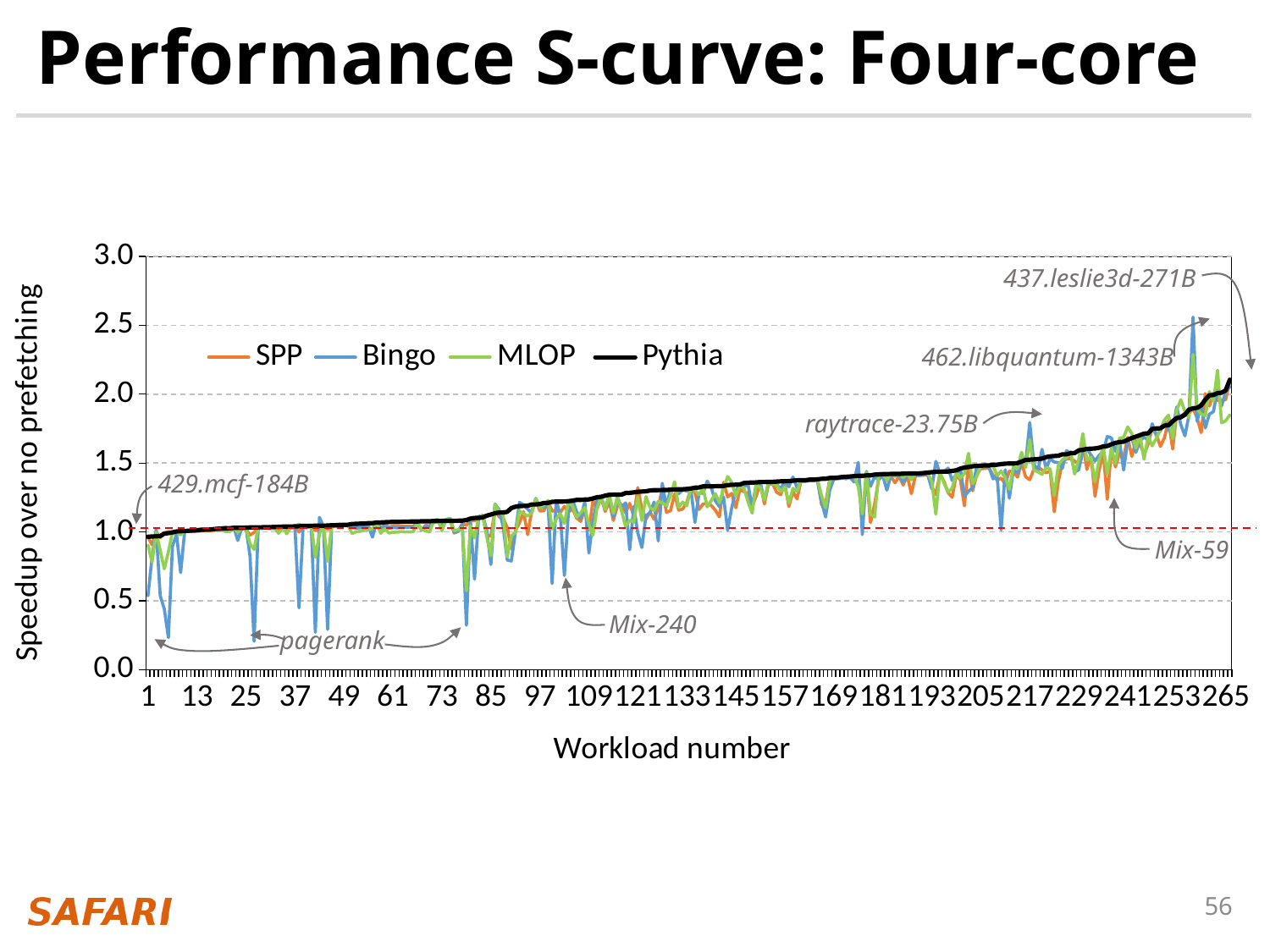
Is the peak Bingo value near workload 257 greater or less than 2.0? greater What is the label of the x axis? Workload number Is the lowest Bingo value in the pagerank region greater or less than 0.5? less What is the label of the y axis? Speedup over no prefetching Is the Pythia value at workload 1 greater or less than 1.5? less How many series does the legend list? 4 Which series are listed in the legend? SPP, Bingo, MLOP, Pythia Does the Pythia line rise or fall as the workload number increases? rise What kind of chart is shown on the slide? line chart What is the title of the chart on the slide? Performance S-curve: Four-core What is the highest workload number labelled on the x axis? 265